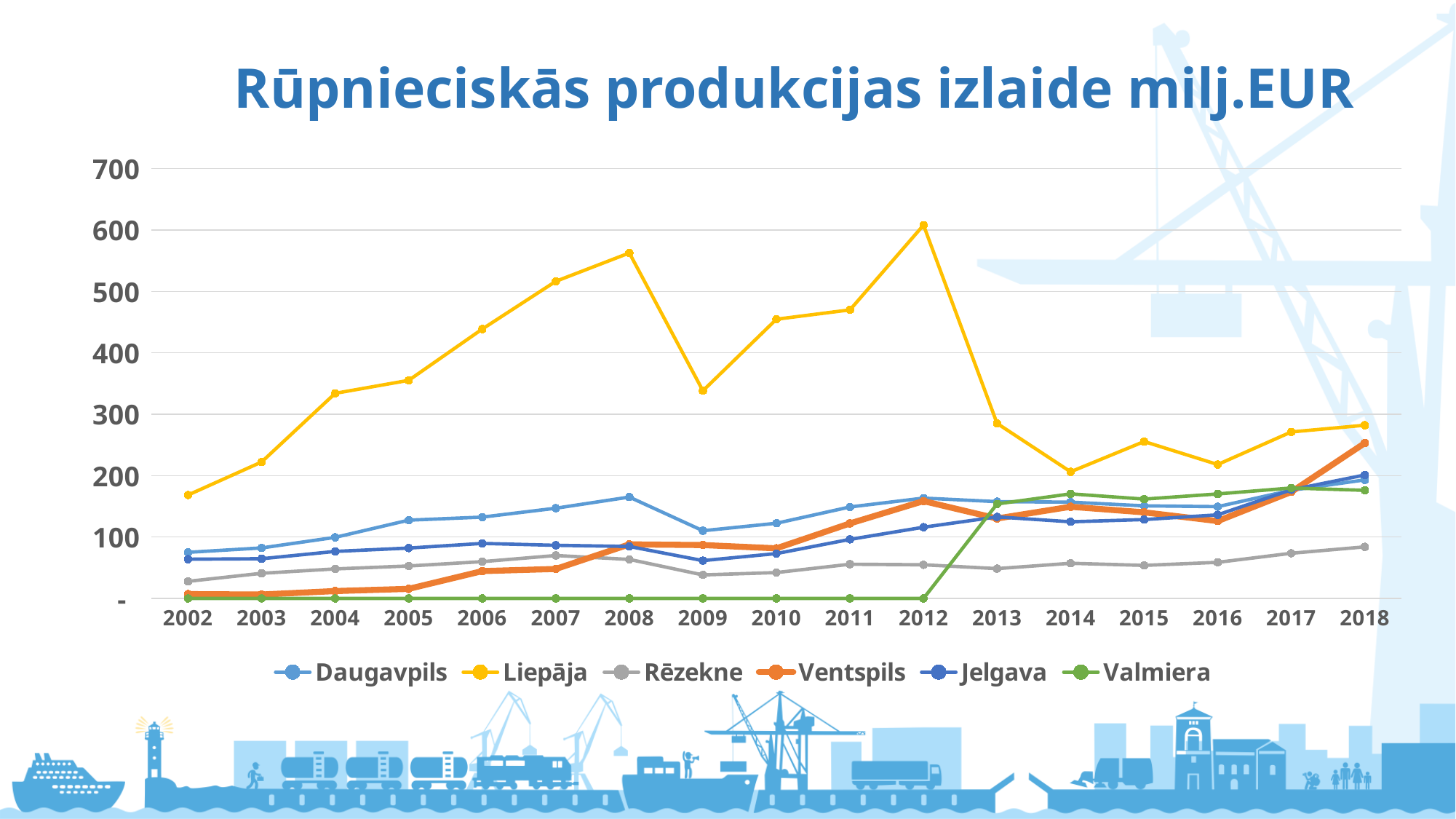
How many series does the legend list? 6 What is the title of the chart? Rūpnieciskās produkcijas izlaide milj.EUR Is the value for Rēzekne in 2018 greater or less than 100? less How many years are shown on the x axis? 17 Is the value for Liepāja in 2008 greater or less than 500? greater Which series has the highest value in 2012? Liepāja What kind of chart is shown on the slide? line chart Which series has the lowest value in 2010? Valmiera In 2002, which is larger: the value for Daugavpils or the value for Ventspils? Daugavpils Is the value for Ventspils in 2018 greater or less than 200? greater Does the Liepāja line rise or fall from 2002 to 2008? rise